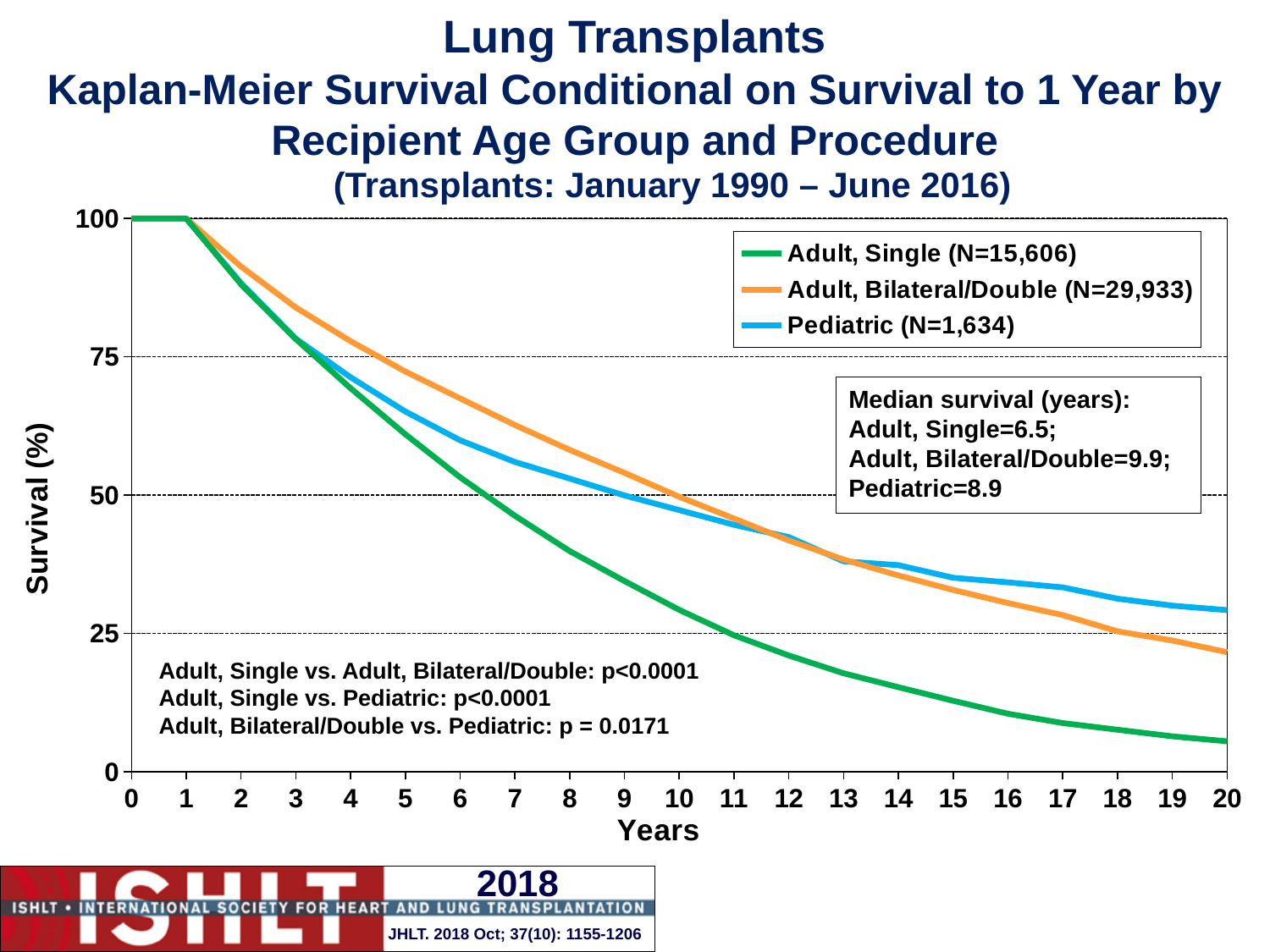
What is the median survival in years for the Adult, Bilateral/Double group? 9.9 Is the survival for Adult, Single at 10 years greater or less than 50? less What is the median survival in years for the Adult, Single group? 6.5 Is the survival for Pediatric at 20 years greater or less than 25? greater How many series does the legend list? 3 What is the difference in median survival (years) between the Adult, Bilateral/Double and Adult, Single groups? 3.4 What kind of chart is shown on the slide? line chart What is the median survival in years for the Pediatric group? 8.9 Which group has the lowest survival at 20 years? Adult, Single Do the survival curves rise or fall as years increase? fall At 5 years, which has higher survival: Adult, Single or Adult, Bilateral/Double? Adult, Bilateral/Double Which group has the highest median survival? Adult, Bilateral/Double